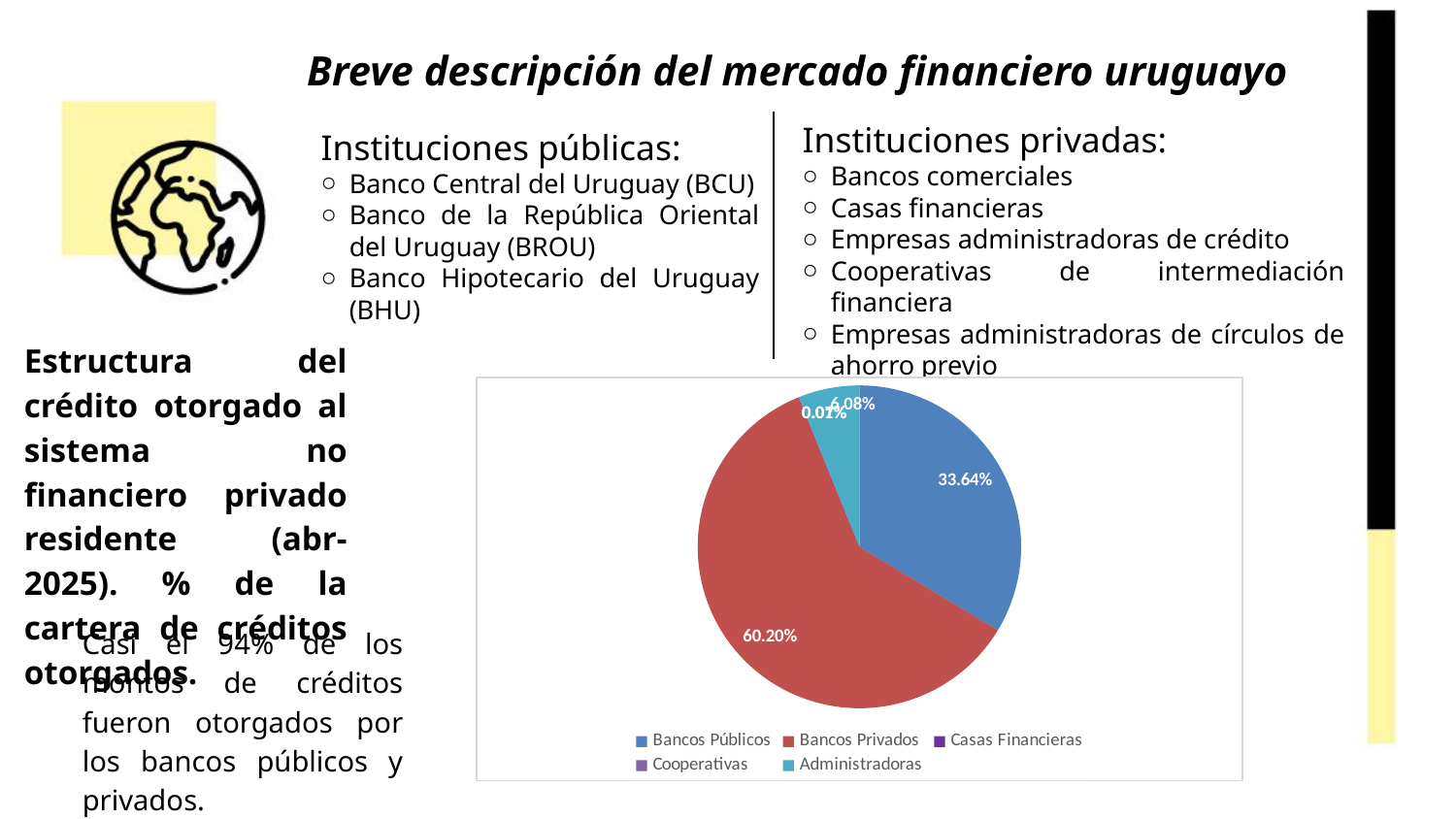
Is the share for Bancos Privados greater or less than 50%? greater What colour is the Bancos Privados slice in the pie chart? red What share of the pie chart corresponds to Administradoras? 6.08% What share of the pie chart corresponds to Bancos Privados? 60.20% What is the combined share of Bancos Públicos and Bancos Privados? 93.84% Which category has the largest slice in the pie chart? Bancos Privados What share of the pie chart corresponds to Bancos Públicos? 33.64% Which slice is larger, Bancos Públicos or Bancos Privados? Bancos Privados How many categories does the legend of the pie chart list? 5 Where is the legend placed relative to the pie chart? below the chart What kind of chart is shown on the slide? pie chart What is the difference between the shares of Bancos Privados and Bancos Públicos? 26.56%